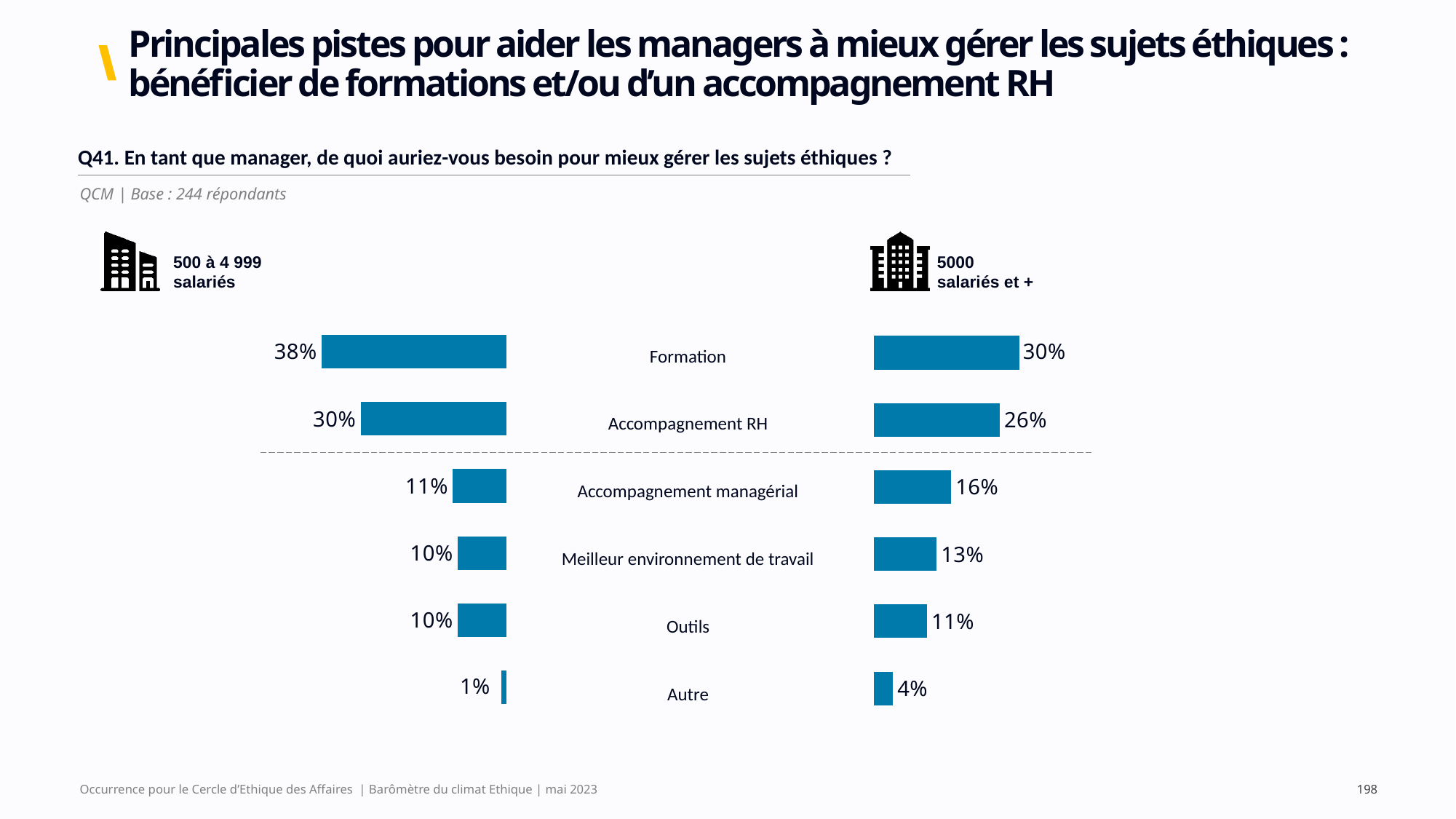
What kind of chart is used on this slide? Bar chart What is the difference between the Formation values in the '500 à 4 999 salariés' chart and the '5000 salariés et +' chart? 8 percentage points In the '500 à 4 999 salariés' chart, which category has the highest value? Formation Which is larger for Accompagnement managérial: the '500 à 4 999 salariés' value or the '5000 salariés et +' value? 5000 salariés et + In the '5000 salariés et +' chart, what is the value for Autre? 4% In the '5000 salariés et +' chart, which category has the lowest value? Autre In the '500 à 4 999 salariés' chart, what is the value for Accompagnement RH? 30% What is the base number of respondents stated on the slide? 244 répondants In the '5000 salariés et +' chart, what is the difference between Formation and Accompagnement RH? 4 percentage points In the '500 à 4 999 salariés' chart, what is the value for Formation? 38% How many categories are shown in the '500 à 4 999 salariés' chart? 6 In the '5000 salariés et +' chart, what is the value for Accompagnement managérial? 16%